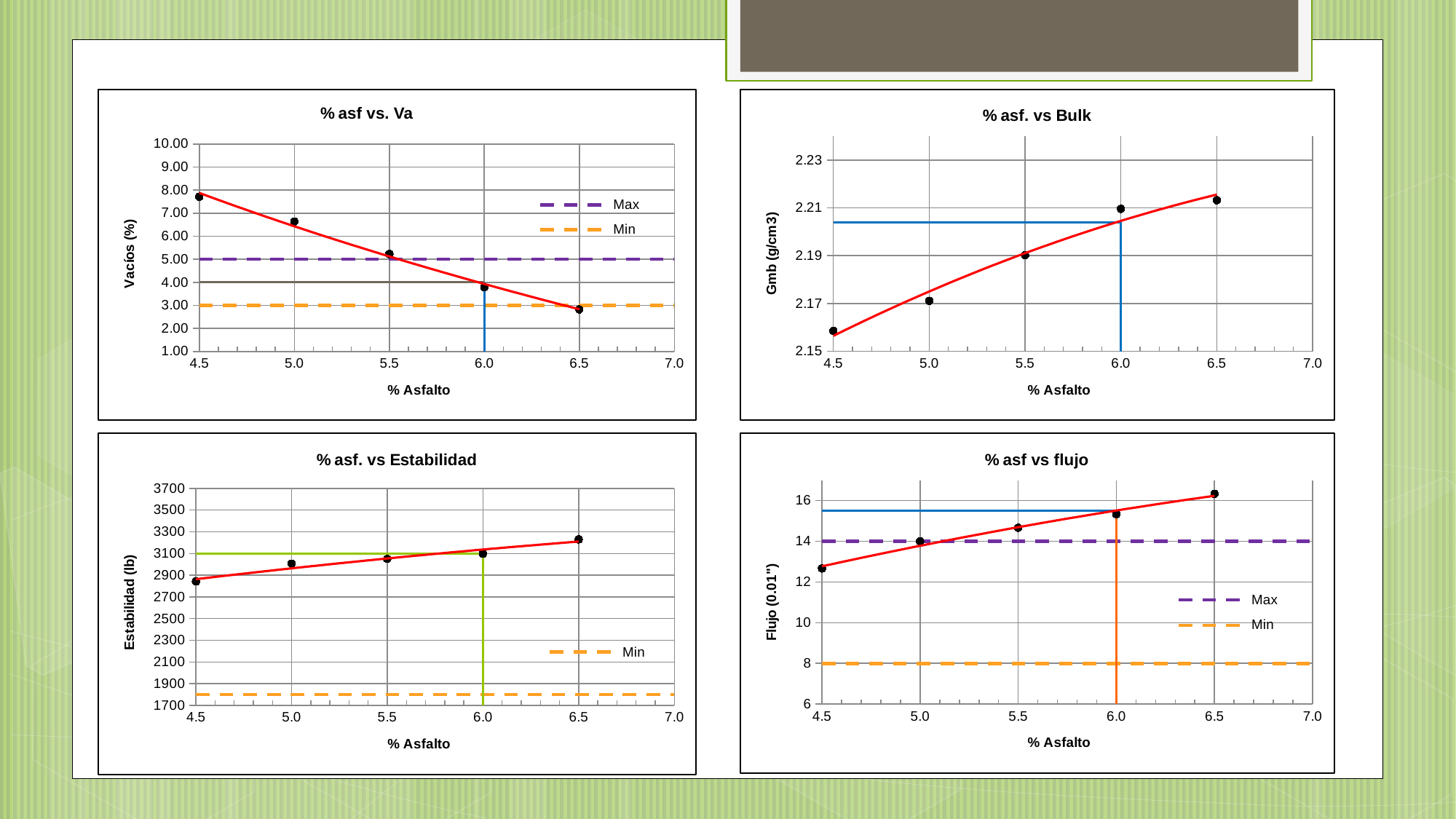
In the '% asf. vs Bulk' chart, at which % Asfalto is the Gmb value lowest? 4.5 In the '% asf. vs Estabilidad' chart, what entry does the legend list? Min In the '% asf vs. Va' chart, is the value at 4.5 % Asfalto greater or less than 7.00? greater In the '% asf vs. Va' chart, do the values rise or fall as % Asfalto increases? fall What kind of chart is the '% asf vs. Va' chart? scatter chart with a trend line In the '% asf vs. Va' chart, how many entries does the legend list? 2 In the '% asf vs. Va' chart, how many data points are plotted? 5 In the '% asf vs flujo' chart, is the value at 6.0 % Asfalto greater or less than 16? less In the '% asf vs. Va' chart, at which % Asfalto is the Vacios value highest? 4.5 In the '% asf. vs Bulk' chart, is the value at 4.5 % Asfalto greater or less than 2.17? less In the '% asf. vs Bulk' chart, do the Gmb values rise or fall as % Asfalto increases? rise